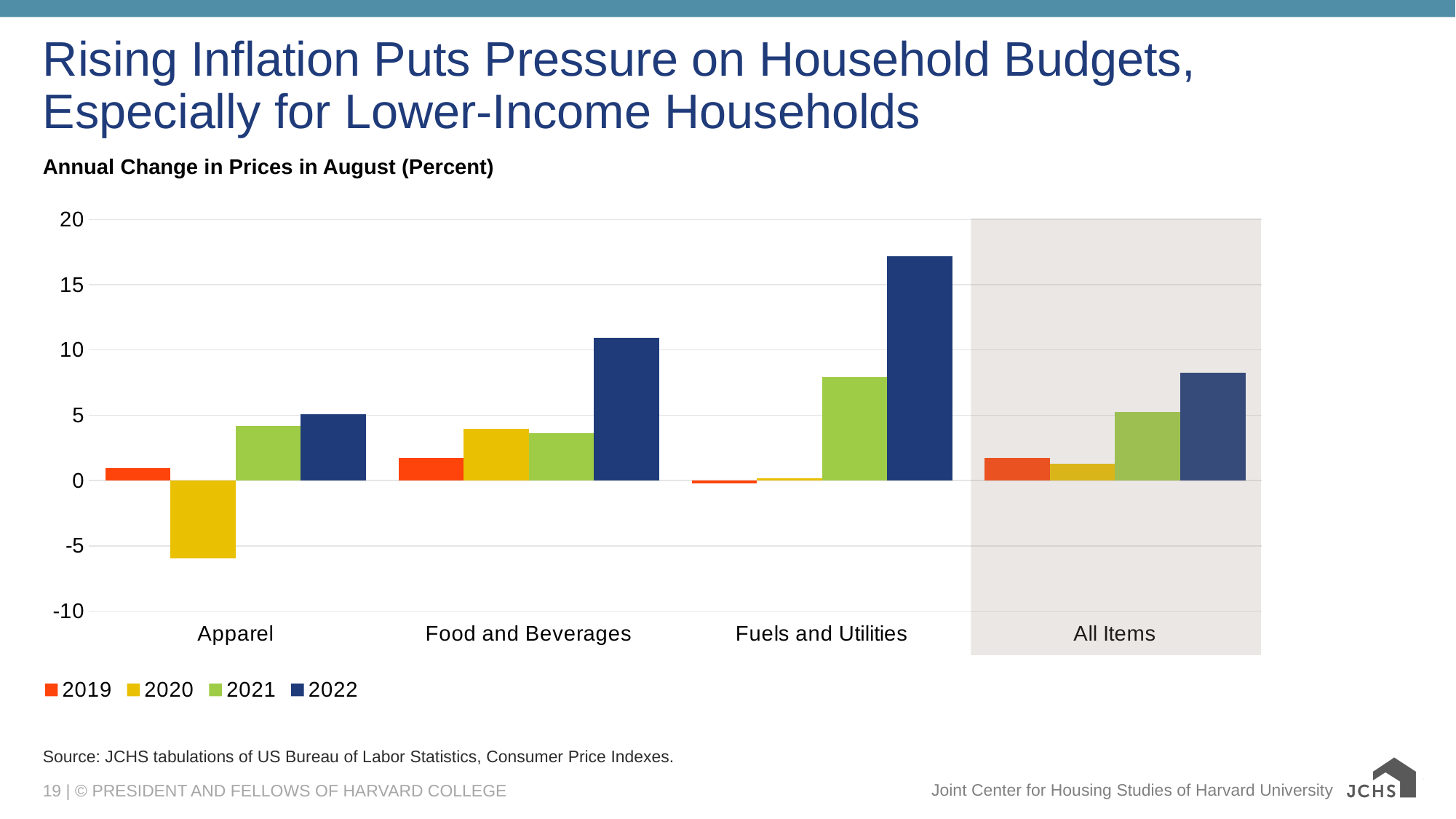
Which category has the highest value for 2022? Fuels and Utilities Which category has the lowest value for 2020? Apparel How many categories are shown on the x axis? 4 Which category is highlighted with a shaded background on the chart? All Items Is the 2020 value for Apparel greater or less than -5? less Is the 2021 value for Fuels and Utilities greater or less than 5? greater Which is larger, the 2022 value for Apparel or the 2022 value for All Items? All Items Which is larger, the 2021 value for Fuels and Utilities or the 2021 value for Food and Beverages? Fuels and Utilities Is the 2022 value for Food and Beverages greater or less than 10? greater How many series does the legend list? 4 What kind of chart is shown on the slide? Bar chart